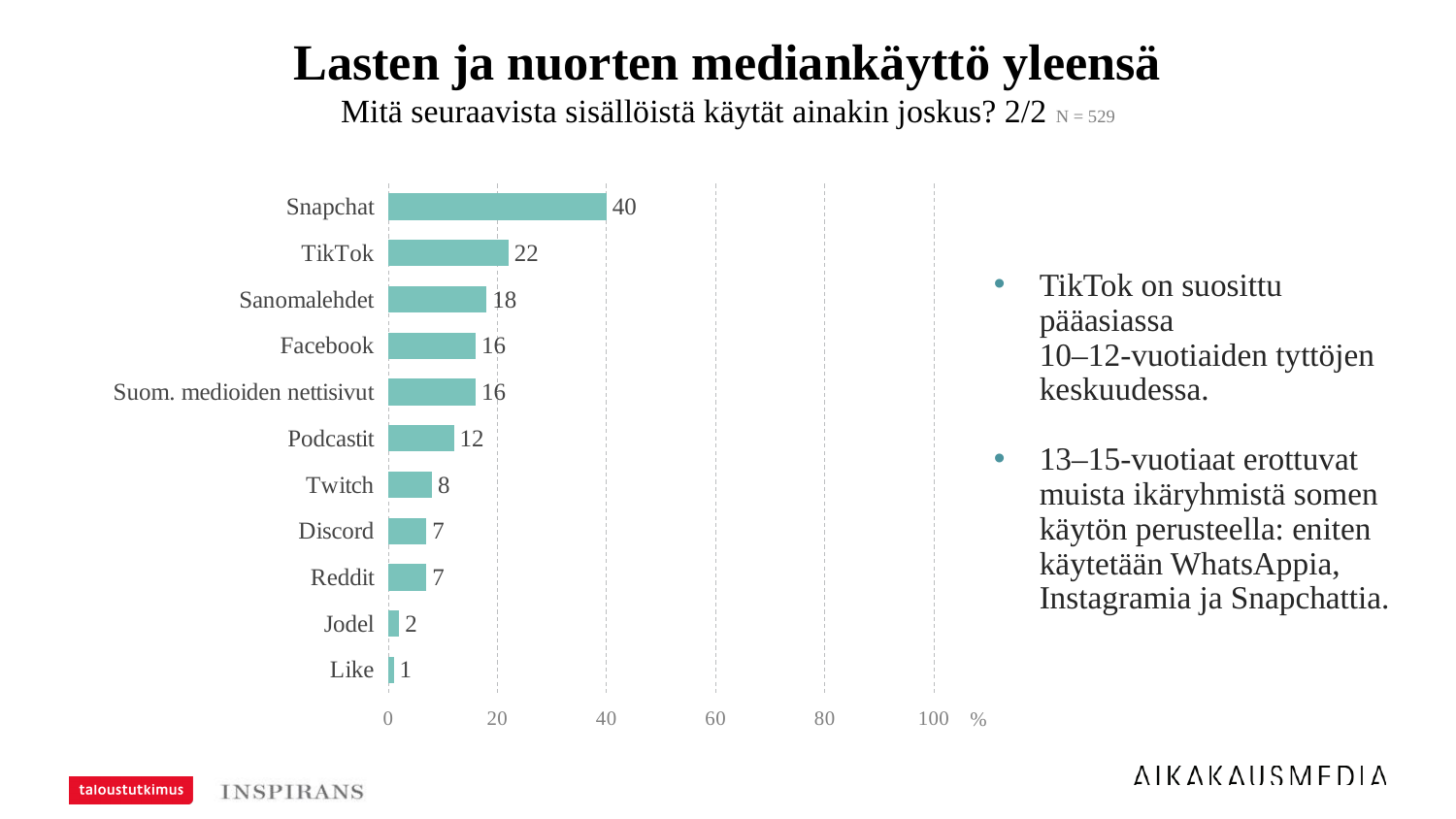
What is the value for Jodel? 2 How many categories are shown in the chart? 11 Which category has the highest value? Snapchat What is the value for Sanomalehdet? 18 What is the difference between the values for Snapchat and TikTok? 18 Is the value for Snapchat greater or less than 20? greater What kind of chart is shown on the slide? Bar chart What is the value for Snapchat? 40 What unit is shown at the end of the x axis? % Which has a larger value, Twitch or Podcastit? Podcastit Which category has the lowest value? Like What is the value for Podcastit? 12